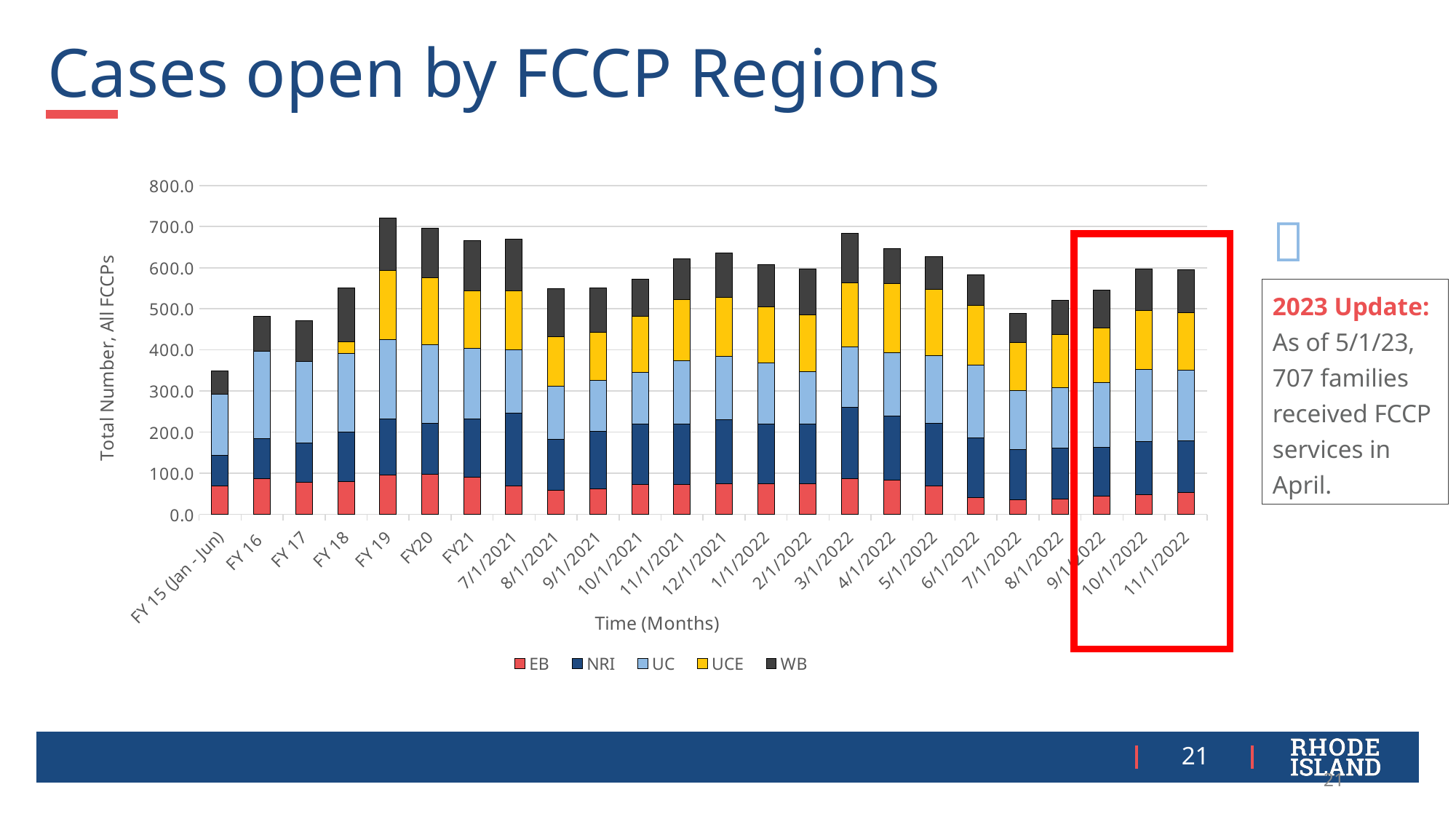
What is the label of the x axis? Time (Months) Do the totals rise or fall from FY 15 (Jan - Jun) to FY 19? rise Is the total for 7/1/2022 greater or less than 500? less How many series does the legend list? 5 Which has a larger total, FY 16 or FY 19? FY 19 Which category has the lowest total number of cases? FY 15 (Jan - Jun) Which category has the highest total number of cases? FY 19 Which has a larger total, 3/1/2022 or 7/1/2022? 3/1/2022 Is the total for FY 15 (Jan - Jun) greater or less than 400? less How many categories are shown along the x axis? 24 What kind of chart is shown on the slide? Stacked bar chart Is the total for FY 19 greater or less than 700? greater